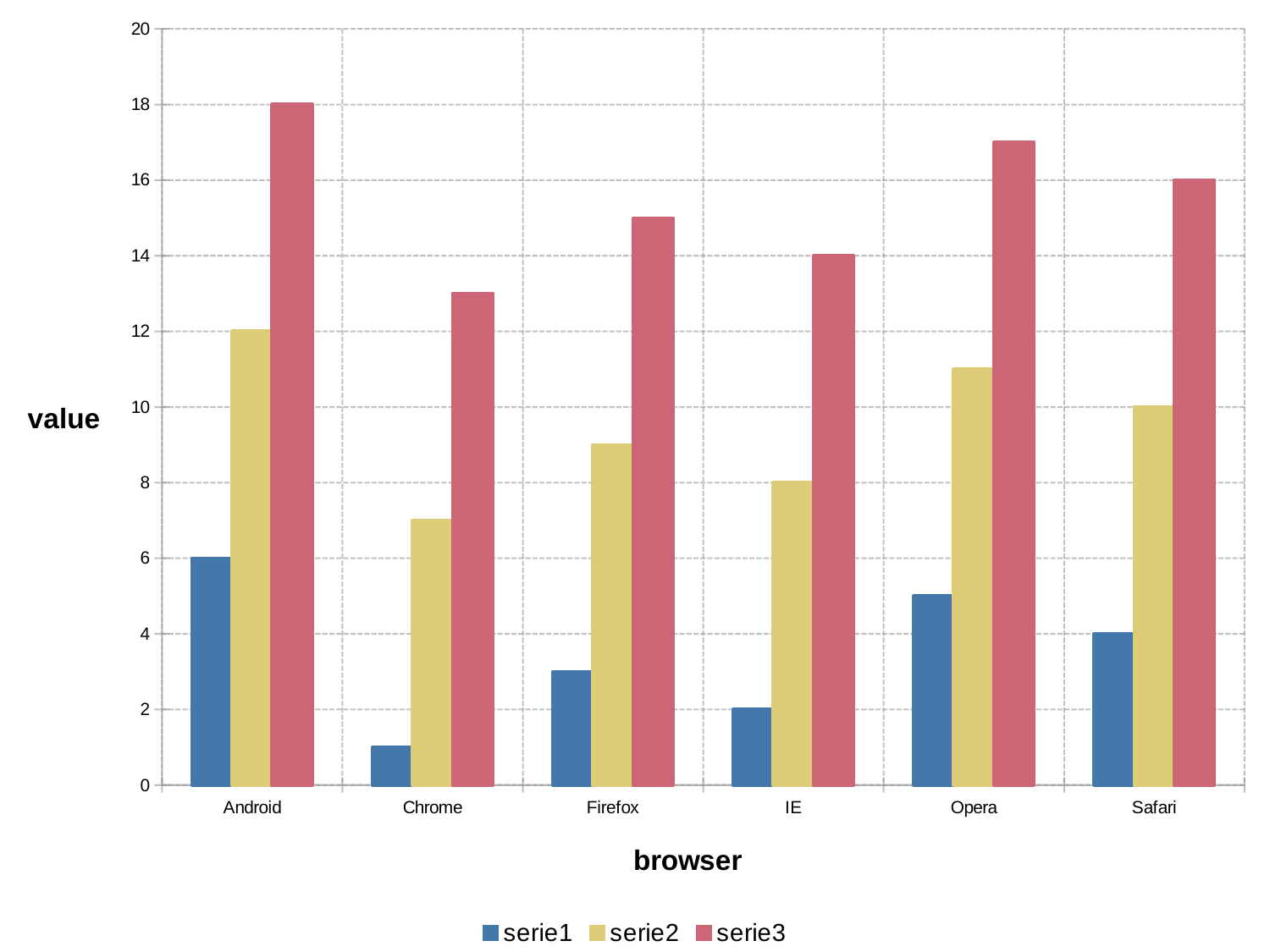
What is the label of the y axis? value What is the value of serie1 for IE? 2 How many browsers are shown on the x axis? 6 What is the value of serie2 for Safari? 10 Which browser has the lowest serie1 value? Chrome What is the difference between the serie3 and serie1 values for Android? 12 What kind of chart is this? bar chart What is the value of serie3 for Android? 18 Which browser has the highest serie3 value? Android Is the serie3 value for Chrome greater or less than 12? greater Which is larger, the serie2 value for IE or the serie2 value for Safari? Safari How many series does the legend list? 3